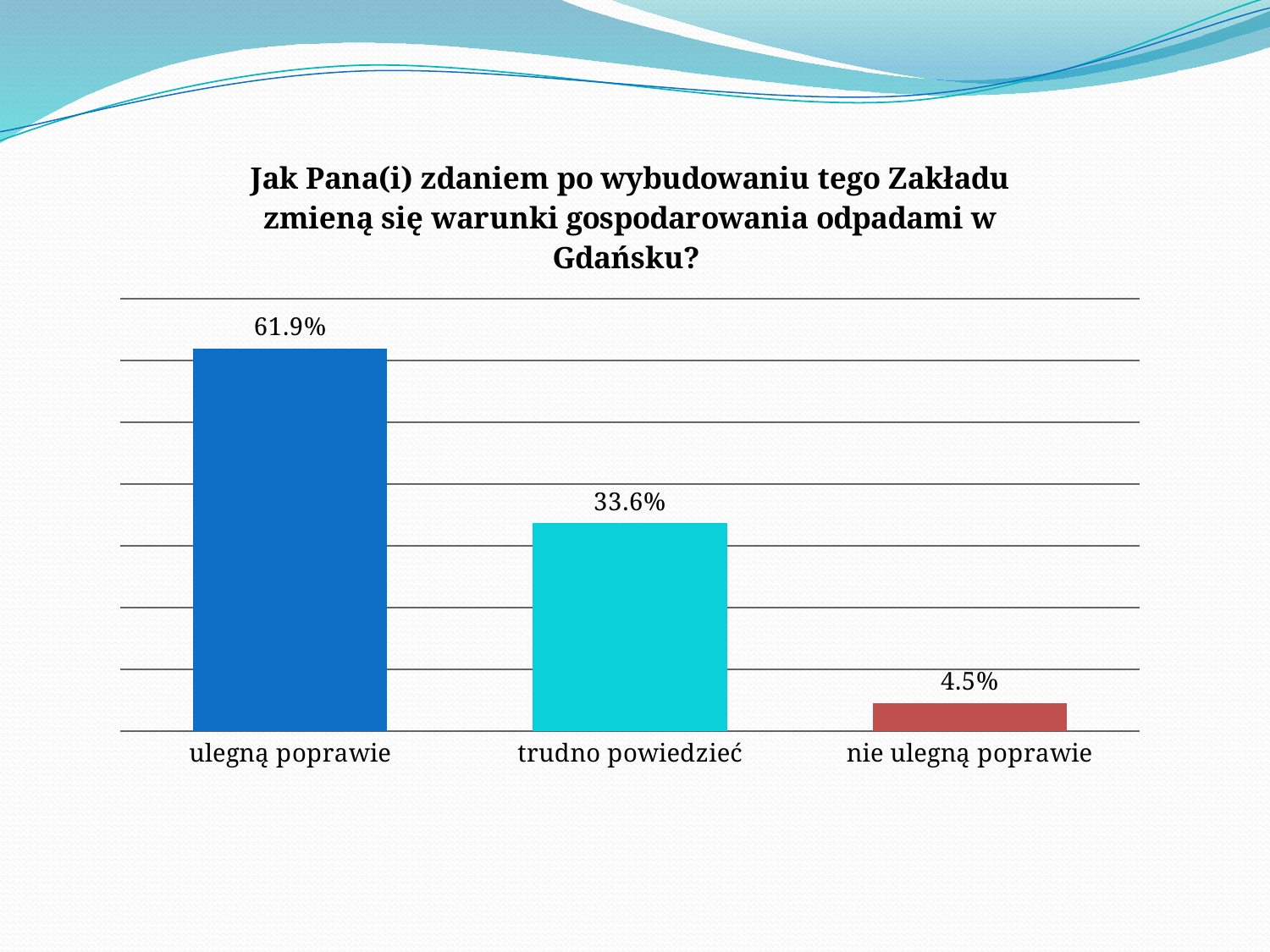
How many categories are shown on the chart? 3 Do the values rise or fall from left to right across the categories? fall What kind of chart is shown on the slide? bar chart Which is larger, the value for "trudno powiedzieć" or the value for "nie ulegną poprawie"? trudno powiedzieć What colour is the bar for "nie ulegną poprawie"? red What is the value for "trudno powiedzieć"? 33.6% What is the value for "nie ulegną poprawie"? 4.5% Which category has the lowest value? nie ulegną poprawie What is the difference between the values for "ulegną poprawie" and "trudno powiedzieć"? 28.3% What is the value for "ulegną poprawie"? 61.9% Which category has the highest value? ulegną poprawie What is the difference between the values for "trudno powiedzieć" and "nie ulegną poprawie"? 29.1%